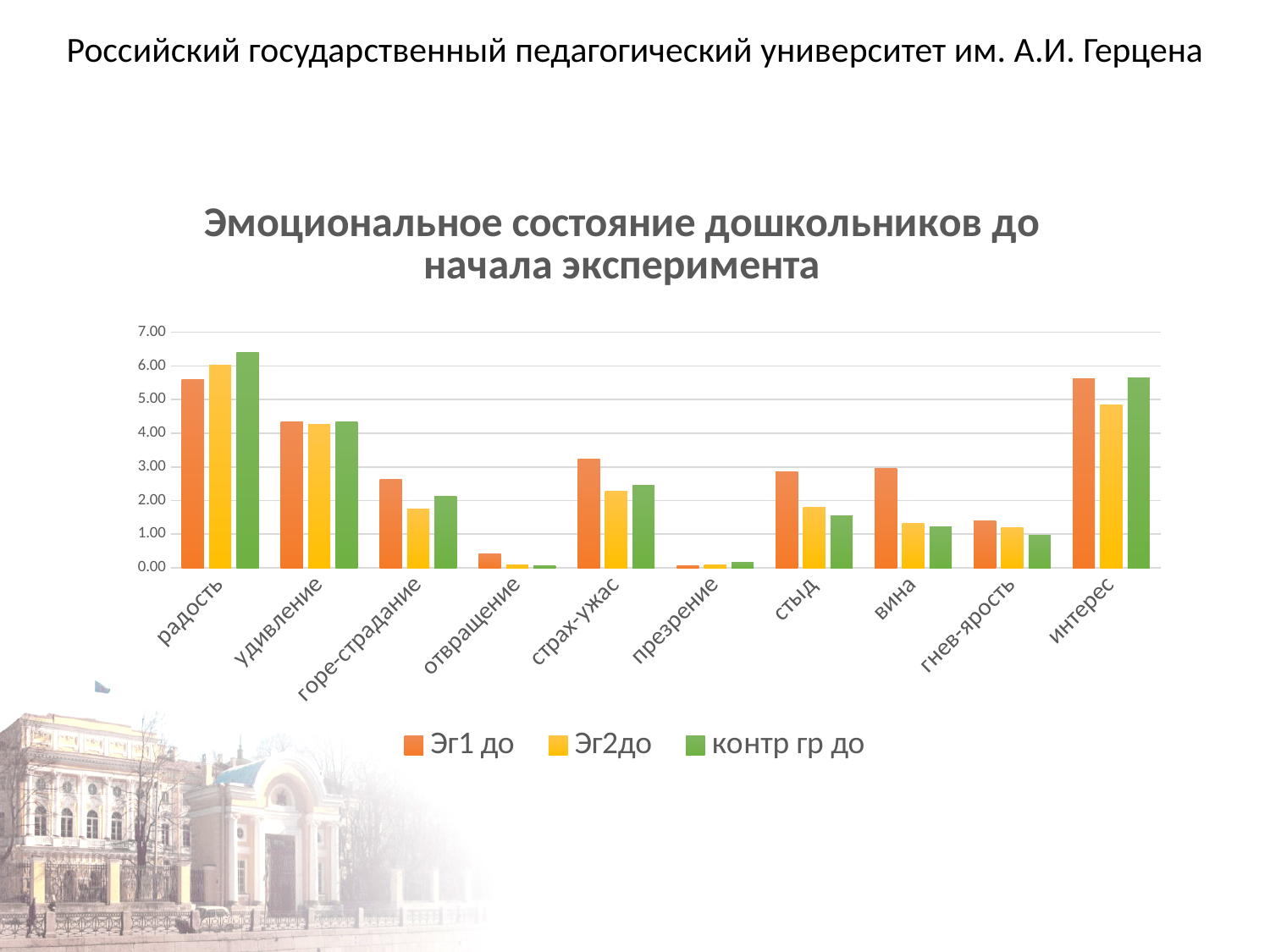
What kind of chart is shown on the slide? bar chart For the series Эг2до, which category has the highest value? радость Is the value of Эг1 до for страх-ужас greater or less than 3.00? greater For the series контр гр до, which category has the highest value? радость Is the value of Эг2до for радость greater or less than 5.00? greater For the series Эг1 до, which category has the lowest value? презрение Is the value of контр гр до for вина greater or less than 2.00? less How many emotion categories are shown on the x axis? 10 How many series does the legend list? 3 What is the title of the chart? Эмоциональное состояние дошкольников до начала эксперимента For радость, which is larger: Эг1 до or контр гр до? контр гр до For горе-страдание, which is larger: Эг1 до or Эг2до? Эг1 до